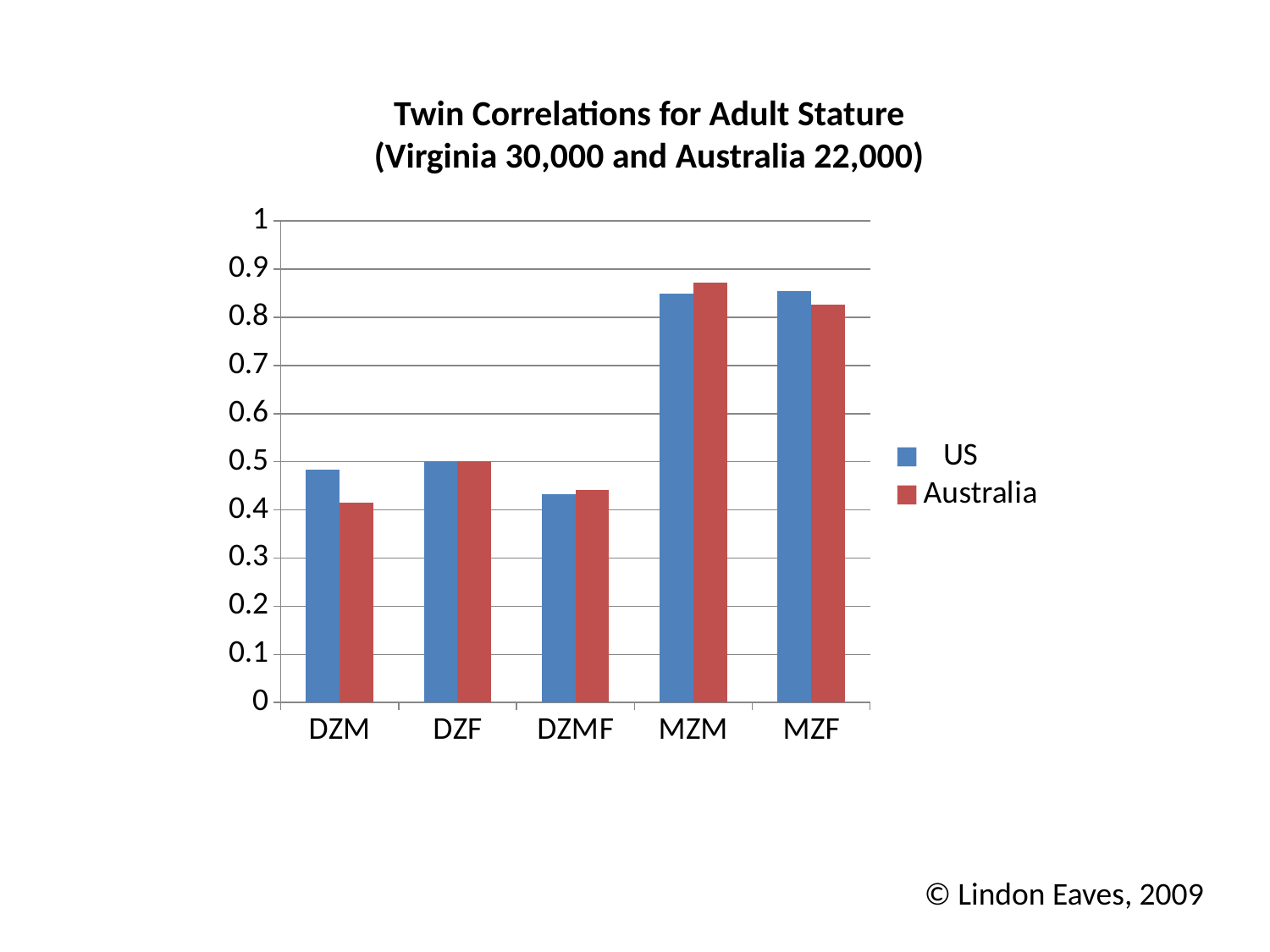
Is the US value for MZF greater or less than 0.8? greater Is the US value for DZMF greater or less than 0.5? less Is the Australia value for MZM greater or less than 0.8? greater Which category has the lowest US value? DZMF Which series does the red bar represent? Australia What is the title of the chart? Twin Correlations for Adult Stature (Virginia 30,000 and Australia 22,000) Which category has the highest Australia value? MZM For DZM, which is larger, the US value or the Australia value? US How many series does the legend list? 2 What kind of chart is shown on the slide? bar chart How many twin categories are shown on the x axis? 5